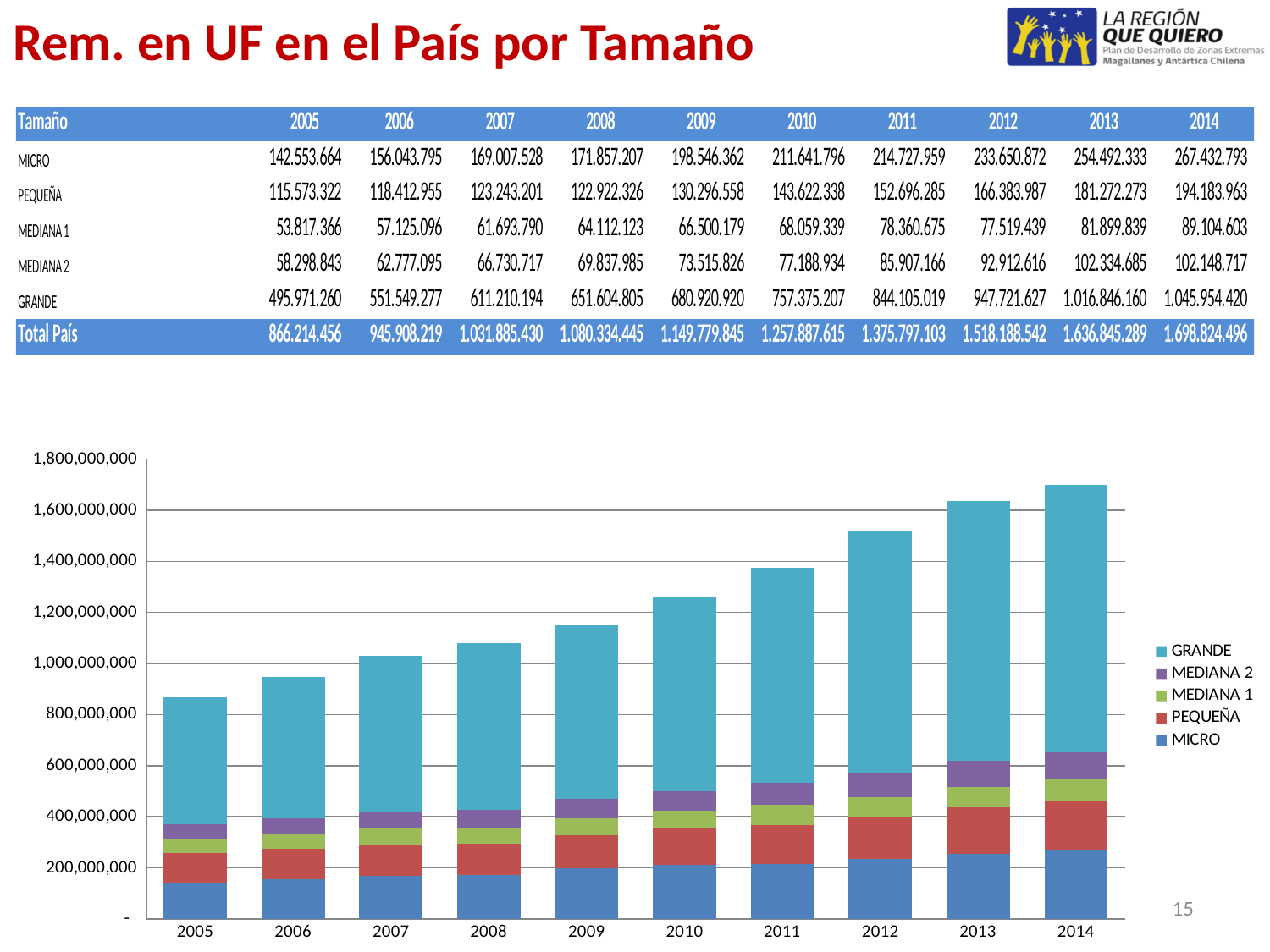
What is the difference between the Total País values for 2014 and 2005? 832.610.040 In 2014, which segment is larger, GRANDE or MICRO? GRANDE Is the total bar for 2010 greater or less than 1,200,000,000? greater Which year has the tallest stacked bar? 2014 According to the table, what is the Total País value for 2005? 866.214.456 How many series does the chart legend list? 5 Which year has the shortest stacked bar? 2005 Is the total bar for 2006 greater or less than 1,000,000,000? less According to the table, what is the value for GRANDE in 2014? 1.045.954.420 What kind of chart is shown on the slide? Stacked bar chart Do the total bar heights rise or fall from 2005 to 2014? Rise How many years are shown along the x axis of the chart? 10